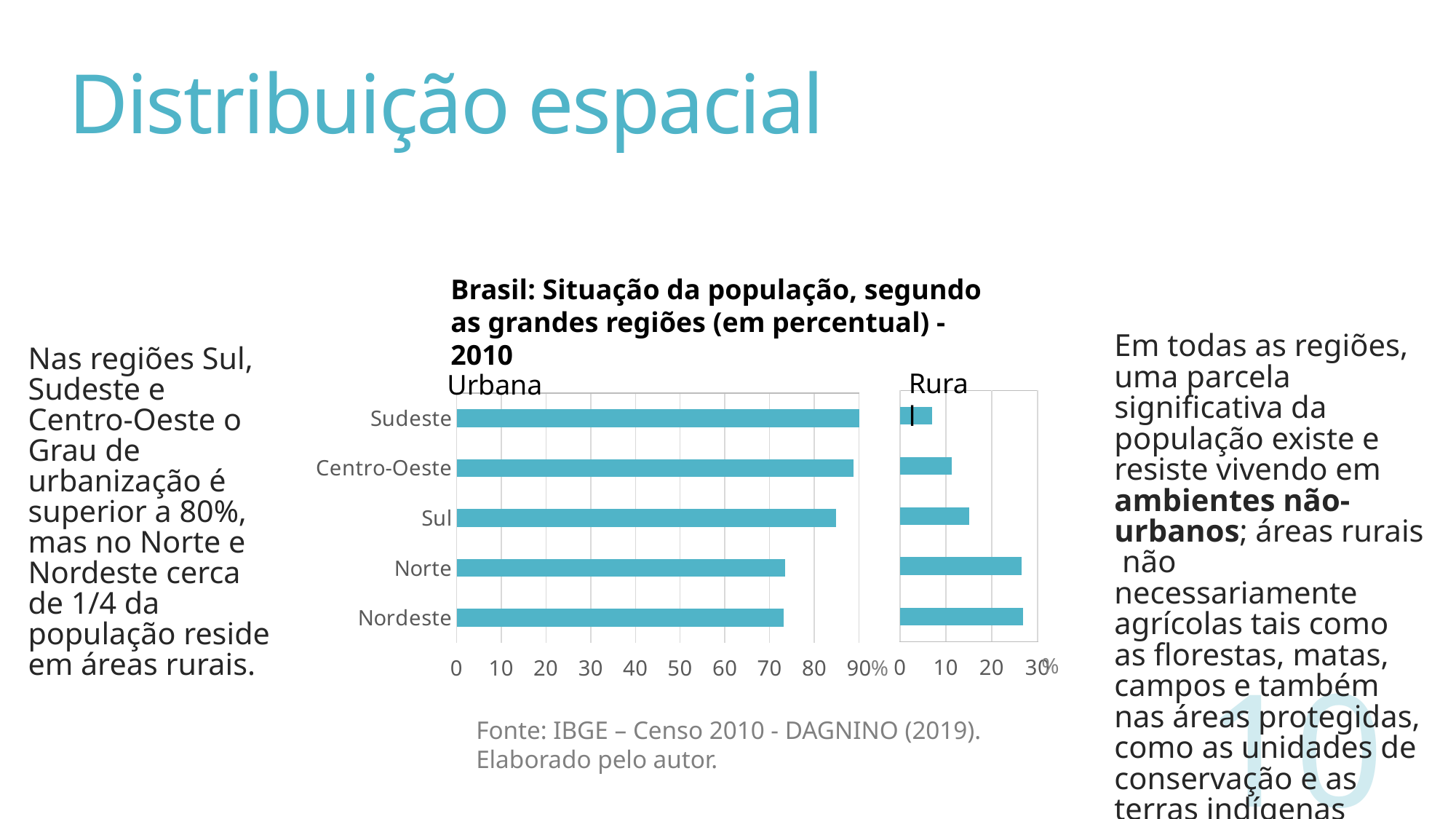
In the Rural chart, which is larger, the value for Sul or the value for Sudeste? Sul In the Urbana chart, is the value for Sudeste greater or less than 80? greater In the Rural chart, is the value for Sul greater or less than 10? greater In the Urbana chart, is the value for Norte greater or less than 80? less In the Rural chart, which region has the lowest value? Sudeste What is the highest tick value on the x axis of the Rural chart? 30% What kind of chart is used for the Urbana chart? bar chart What is the title shown above the two charts? Brasil: Situação da população, segundo as grandes regiões (em percentual) - 2010 In the Urbana chart, which is larger, the value for Sul or the value for Norte? Sul How many regions are shown in the Urbana chart? 5